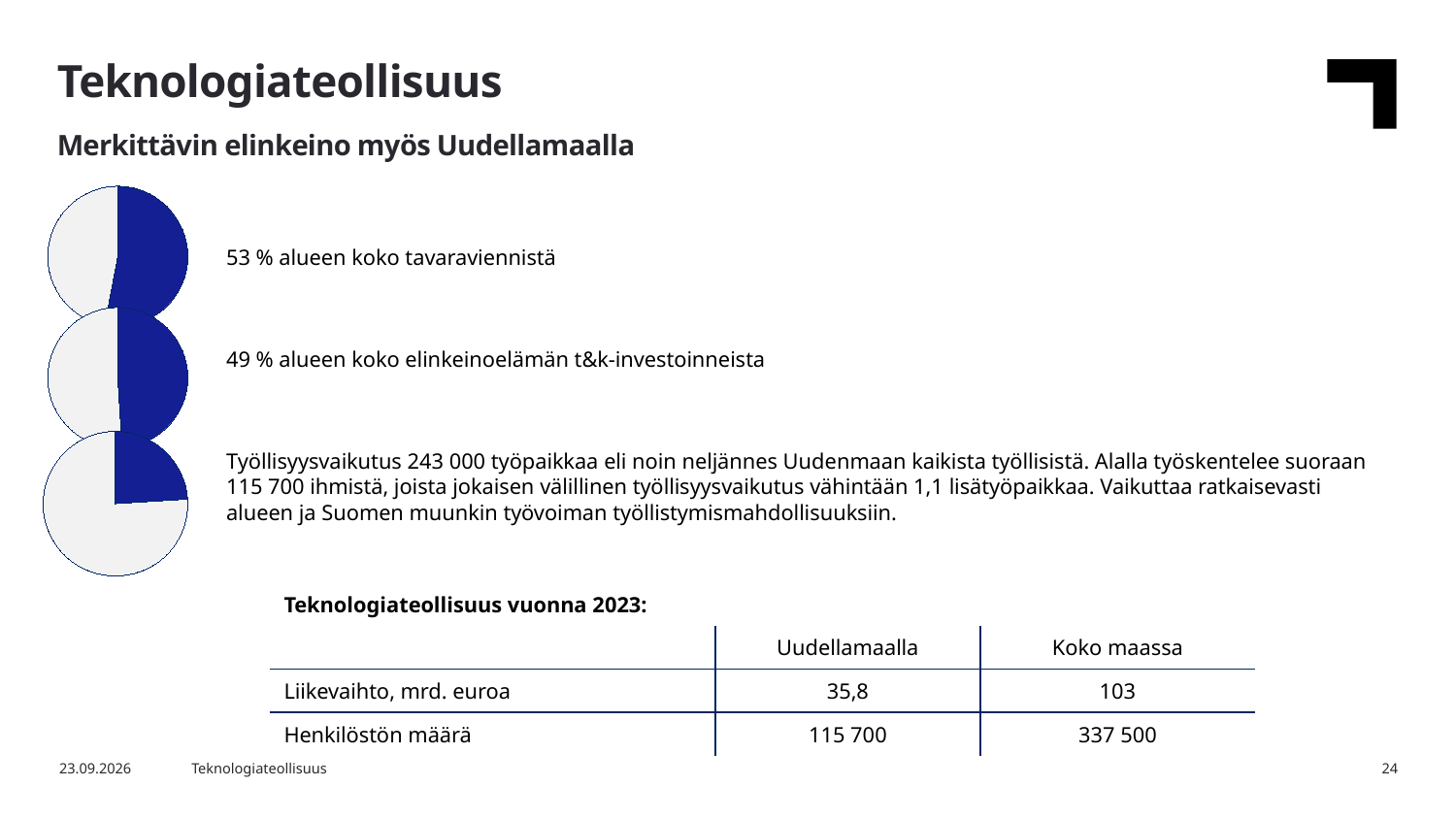
How many slices does each pie chart have? 2 In the middle pie chart, what share of the region's business R&D investments does the blue slice represent? 49 % Is the blue slice in the top pie chart greater or less than 50 % of the pie? greater How many pie charts are shown on the slide? 3 What colour is used for the highlighted slice in each pie chart? Blue What kind of charts are shown on the left side of the slide? Pie charts Is the blue slice in the bottom pie chart greater or less than 50 % of the pie? less Which pie chart has the largest blue slice: the top, middle or bottom one? Top What is the difference in percentage points between the blue slice of the top pie chart (53 %) and the blue slice of the middle pie chart (49 %)? 4 percentage points Which pie chart has the smallest blue slice: the top, middle or bottom one? Bottom In the top pie chart, what share of the region's total goods exports does the blue slice represent? 53 % Is the blue slice in the top pie chart larger or smaller than the blue slice in the middle pie chart? Larger